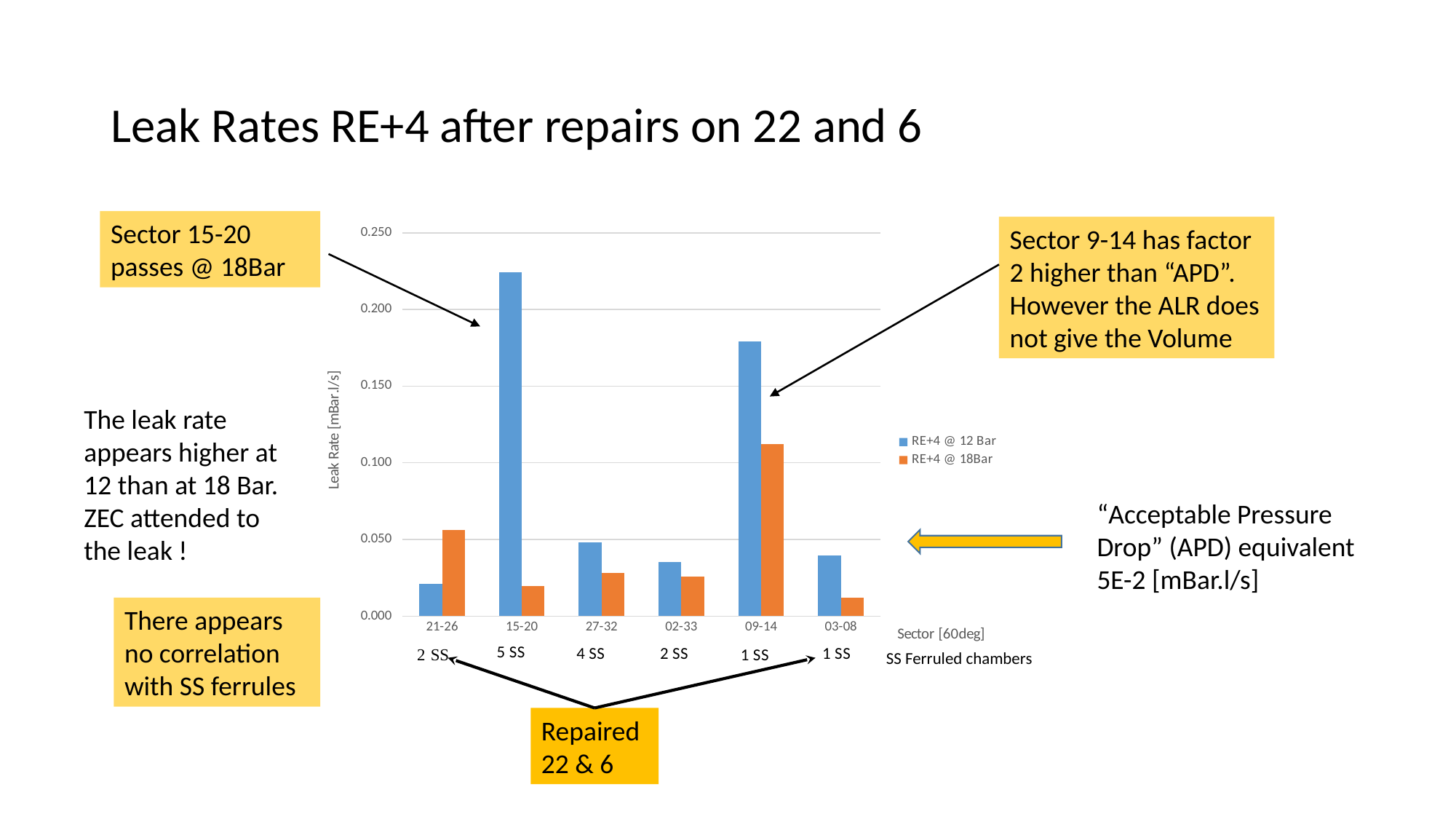
How many sector categories are shown on the x axis of the chart? 6 Which sector has the lowest leak rate for the RE+4 @ 18Bar series? 03-08 Which sector has the lowest leak rate for the RE+4 @ 12 Bar series? 21-26 Is the RE+4 @ 18Bar value for sector 09-14 greater or less than 0.100? greater What kind of chart is shown on the slide? bar chart Which sector has the highest leak rate for the RE+4 @ 18Bar series? 09-14 Which sector has the highest leak rate for the RE+4 @ 12 Bar series? 15-20 How many series does the chart legend list? 2 What is the label of the y axis of the chart? Leak Rate [mBar.l/s] For sector 21-26, which series has the larger value, RE+4 @ 12 Bar or RE+4 @ 18Bar? RE+4 @ 18Bar Is the RE+4 @ 18Bar value for sector 03-08 greater or less than 0.050? less Is the RE+4 @ 12 Bar value for sector 15-20 greater or less than 0.200? greater